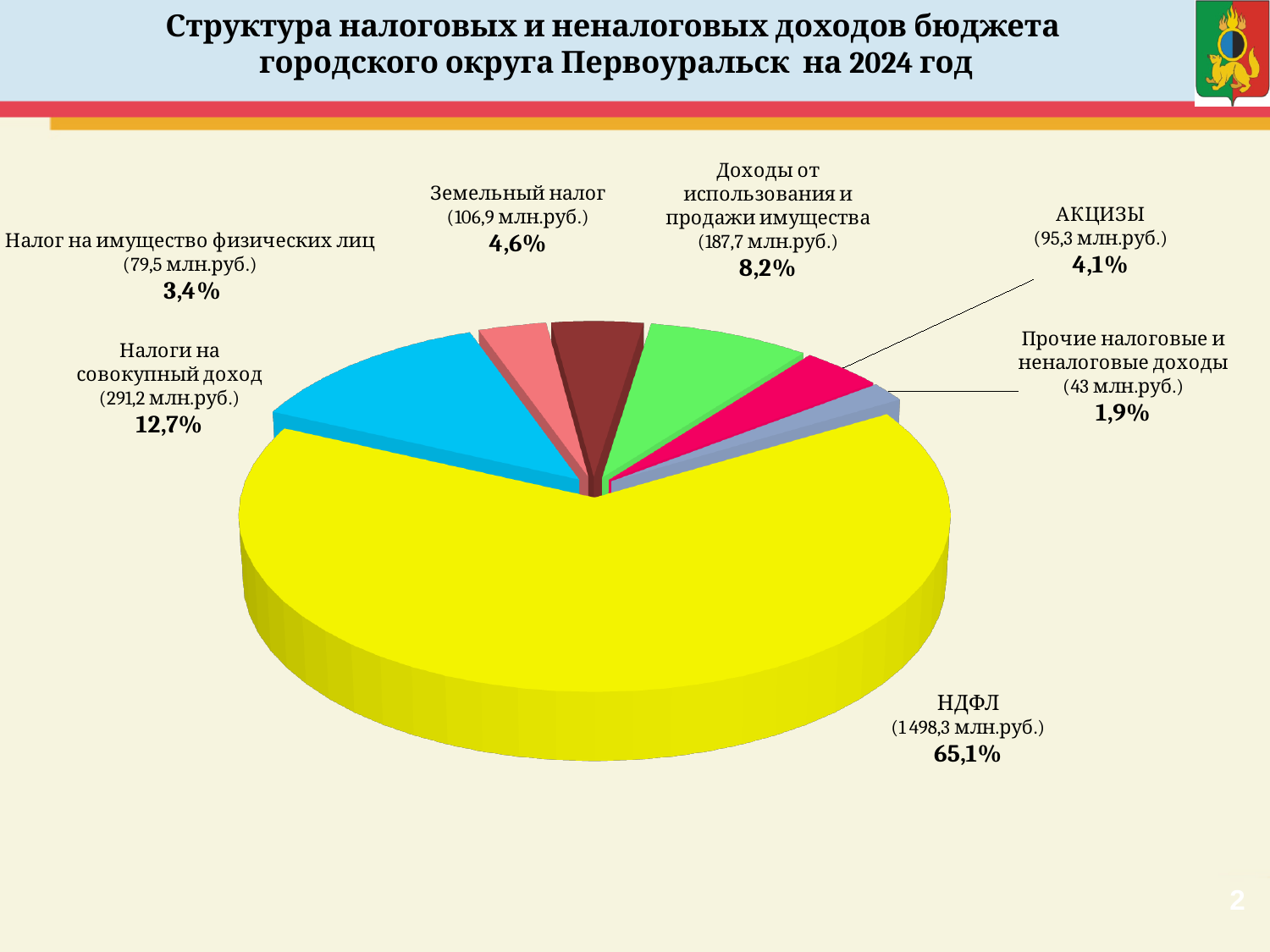
What is the value in million rubles for Налоги на совокупный доход? 291,2 млн.руб. Which is larger: Доходы от использования и продажи имущества or Земельный налог? Доходы от использования и продажи имущества What is the value in million rubles for Земельный налог? 106,9 млн.руб. How many categories (slices) does the pie chart have? 7 What share of the pie does НДФЛ account for? 65,1% What is the difference in million rubles between НДФЛ and Налоги на совокупный доход? 1207,1 млн.руб. What percentage share is shown for АКЦИЗЫ? 4,1% What colour is the НДФЛ slice of the pie? Yellow What kind of chart is shown on the slide? Pie chart Which category has the smallest slice of the pie? Прочие налоговые и неналоговые доходы Which category has the largest slice of the pie? НДФЛ What is the difference in percentage points between Налоги на совокупный доход and Налог на имущество физических лиц? 9,3%